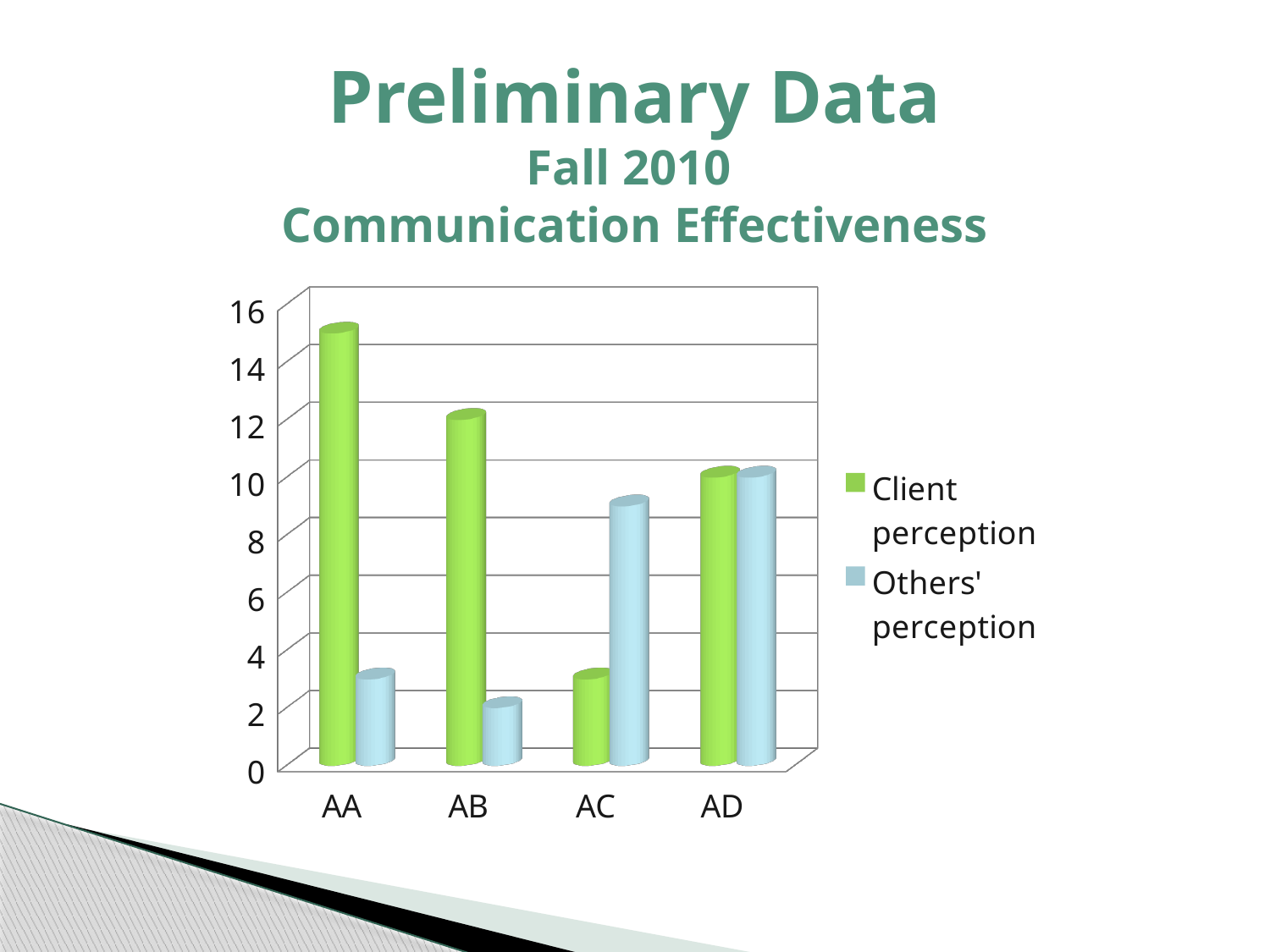
For category AA, which is larger: Client perception or Others' perception? Client perception What are the two series named in the legend? Client perception and Others' perception For category AC, which is larger: Client perception or Others' perception? Others' perception Which category has the highest Others' perception value? AD Is the Others' perception value for AB greater or less than 4? less Is the Client perception value for AA greater or less than 14? greater How many categories are shown on the x axis? 4 Which category has the lowest Others' perception value? AB What kind of chart is shown on the slide? Bar chart Which category has the highest Client perception value? AA Which category has the lowest Client perception value? AC How many series does the legend list? 2